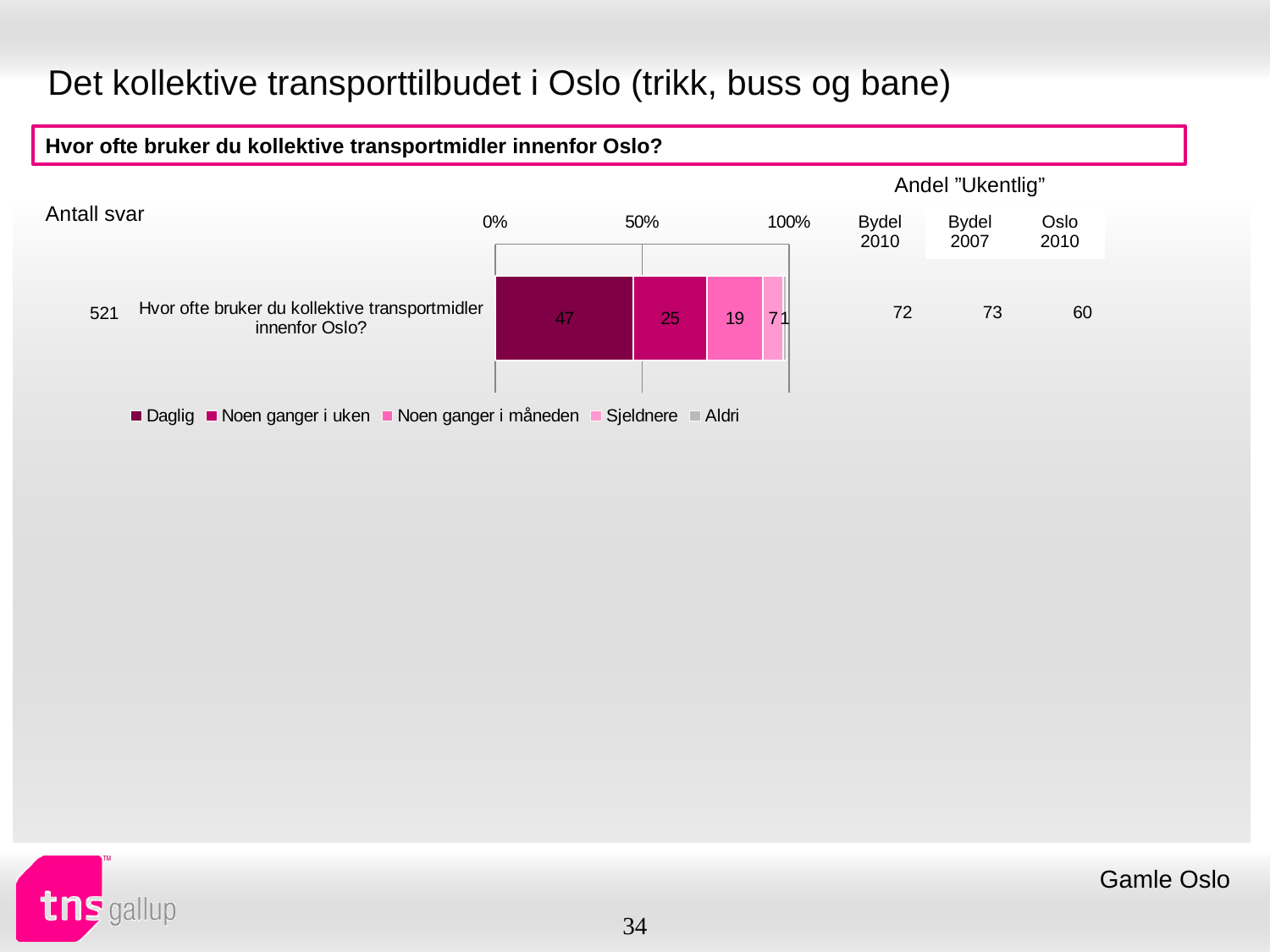
What is the value for "Noen ganger i måneden" in the bar? 19 What is the total of all segments in the stacked bar? 99 What is the value for "Noen ganger i uken" in the bar? 25 What is the value for "Daglig" in the bar? 47 How many series does the legend list? 5 What is the value for "Sjeldnere" in the bar? 7 Which series has the smallest segment in the bar? Aldri Which is larger, the "Noen ganger i måneden" value or the "Sjeldnere" value? Noen ganger i måneden Which series has the largest segment in the bar? Daglig What is the difference between the "Daglig" and "Noen ganger i uken" values? 22 What kind of chart is shown on the slide? stacked bar chart How many categories (bars) does the chart show? 1